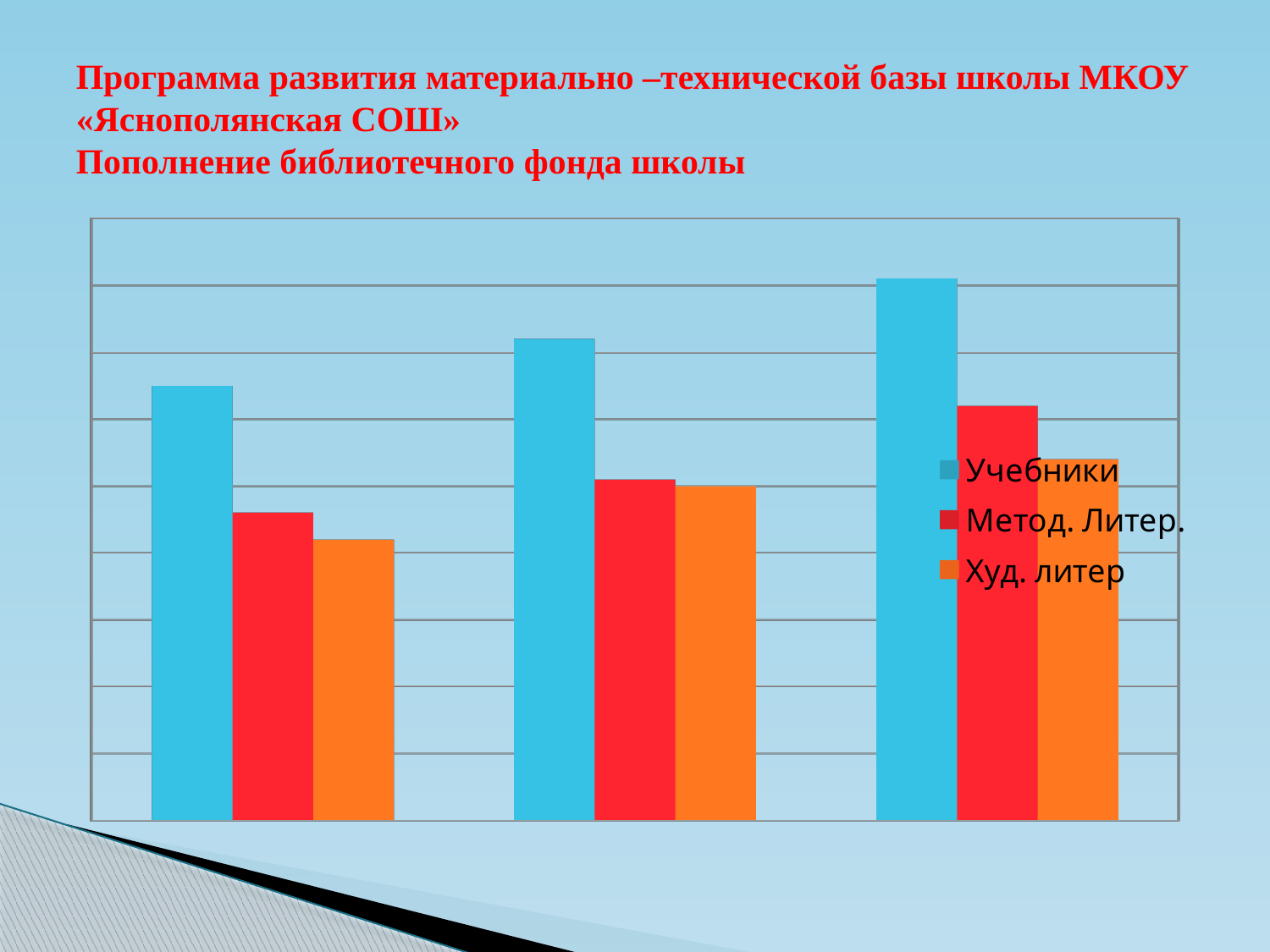
In the first (leftmost) group of bars, which series has the lowest value? Худ. литер Which series is represented by the blue bars? Учебники How many series does the legend list? 3 Which series is represented by the orange bars? Худ. литер What kind of chart is shown on the slide? bar chart How many groups of bars are plotted in the chart? 3 In the third (rightmost) group of bars, which series has the lowest value? Худ. литер Which group of bars has the tallest Учебники bar: the first, second or third? third In the second (middle) group of bars, is the value for Учебники larger or smaller than the value for Метод. Литер.? larger Do the values for Метод. Литер. rise or fall from left to right across the groups? rise Do the values for Учебники rise or fall from left to right across the groups? rise In the first (leftmost) group of bars, which series has the highest value? Учебники